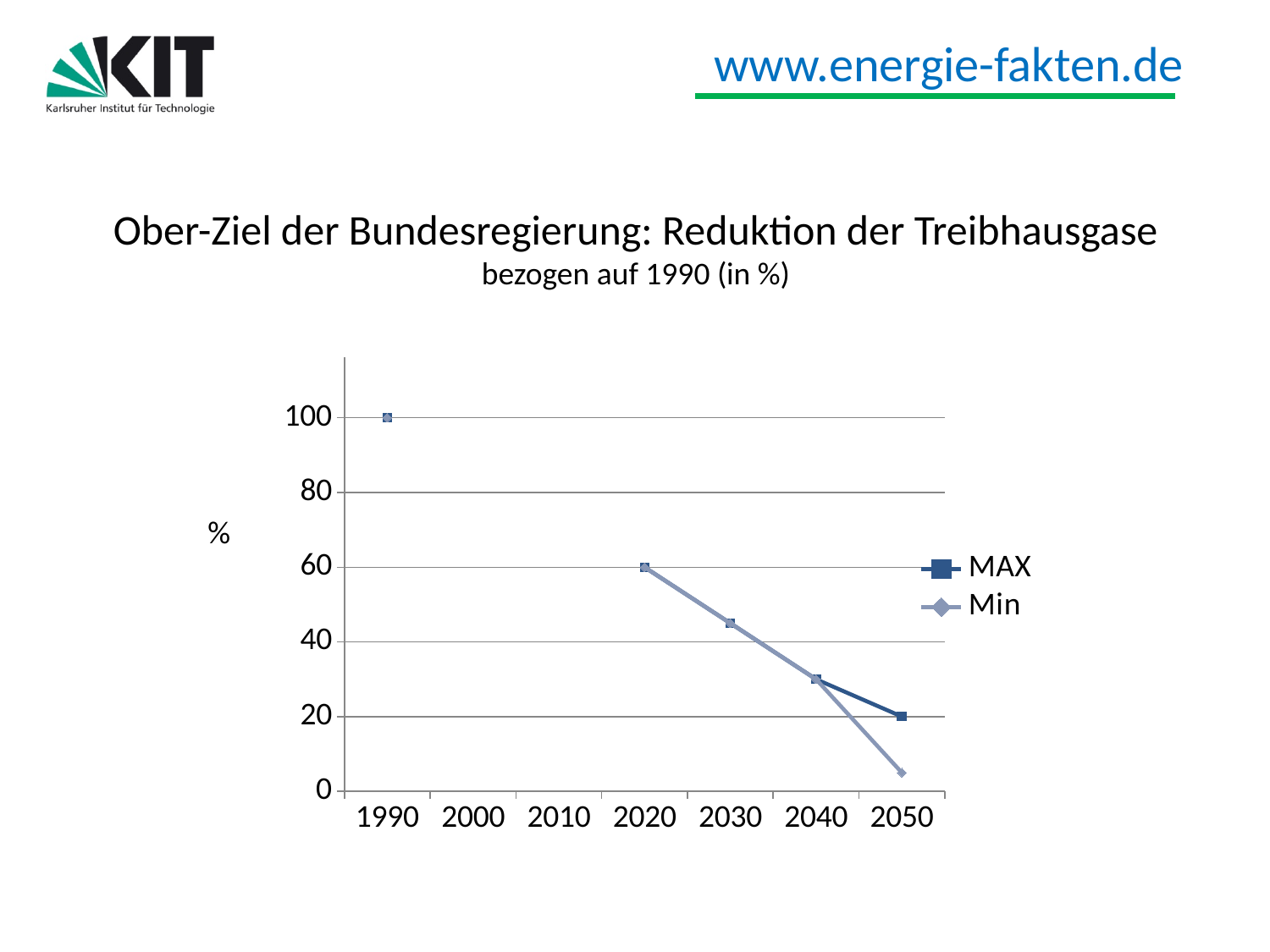
Is the value of the Min series in 2050 greater or less than 20? less Is the value plotted for 2040 greater or less than 40? less What is the value plotted for 2020? 60 What is the value plotted for 1990? 100 Do the plotted values rise or fall from 1990 to 2050? fall Is the value plotted for 2030 greater or less than 40? greater What is the difference between the value in 1990 and the value in 2020? 40 How many series does the legend list? 2 In 2050, which series has the larger value, MAX or Min? MAX What is the value of the MAX series in 2050? 20 What are the two series named in the legend? MAX and Min What kind of chart is shown on the slide? line chart